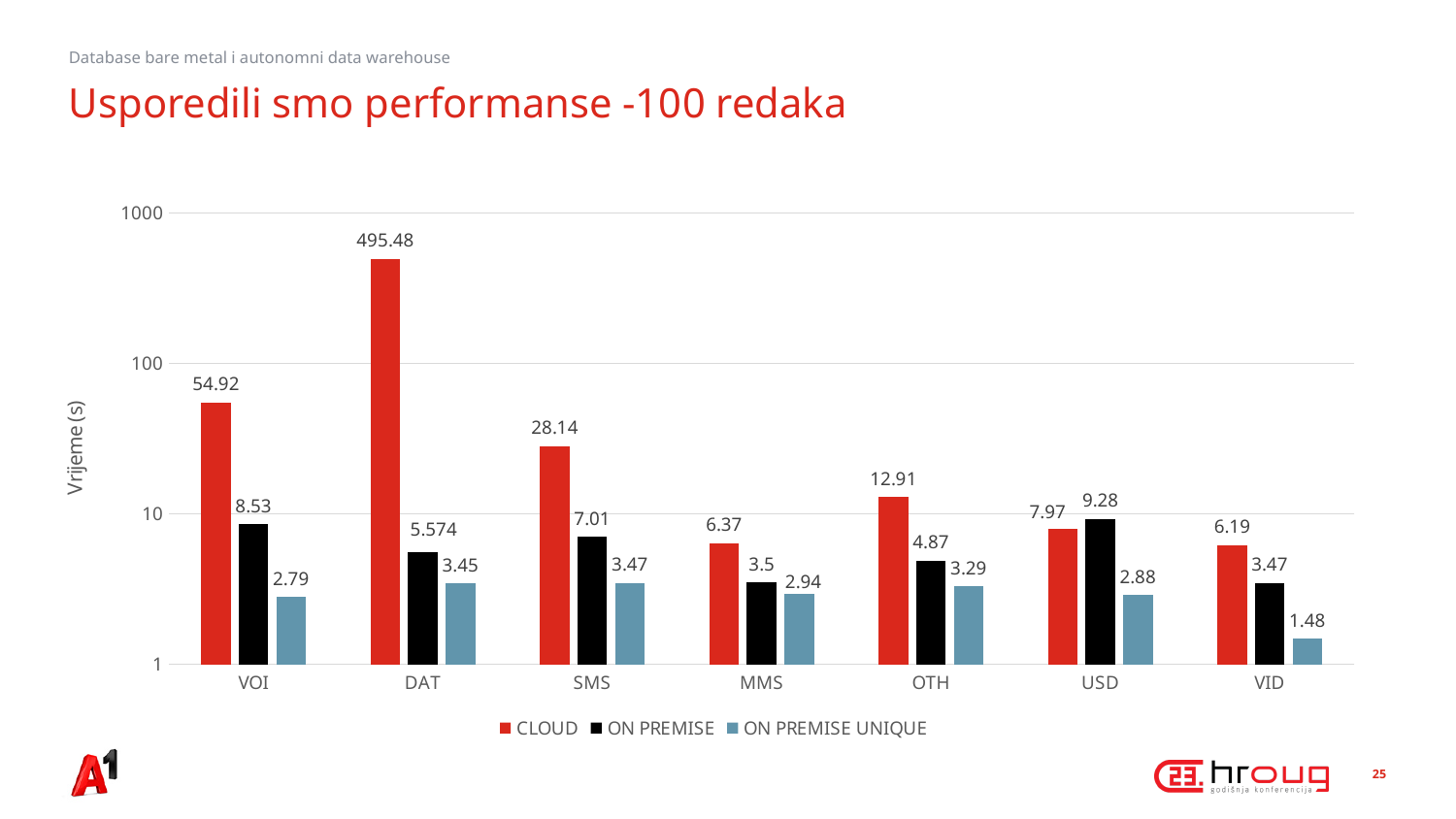
Which category has the lowest ON PREMISE UNIQUE value? VID Is the CLOUD value for OTH greater or less than 10? greater How many categories are shown on the x axis? 7 Which category has the highest CLOUD value? DAT How many series does the legend list? 3 What is the difference between the CLOUD value for VOI and the CLOUD value for SMS? 26.78 For USD, which is larger: the CLOUD value or the ON PREMISE value? ON PREMISE What is the label of the y axis? Vrijeme (s) What is the CLOUD value for DAT? 495.48 What kind of chart is shown on the slide? bar chart What is the ON PREMISE value for VOI? 8.53 What is the ON PREMISE UNIQUE value for VID? 1.48